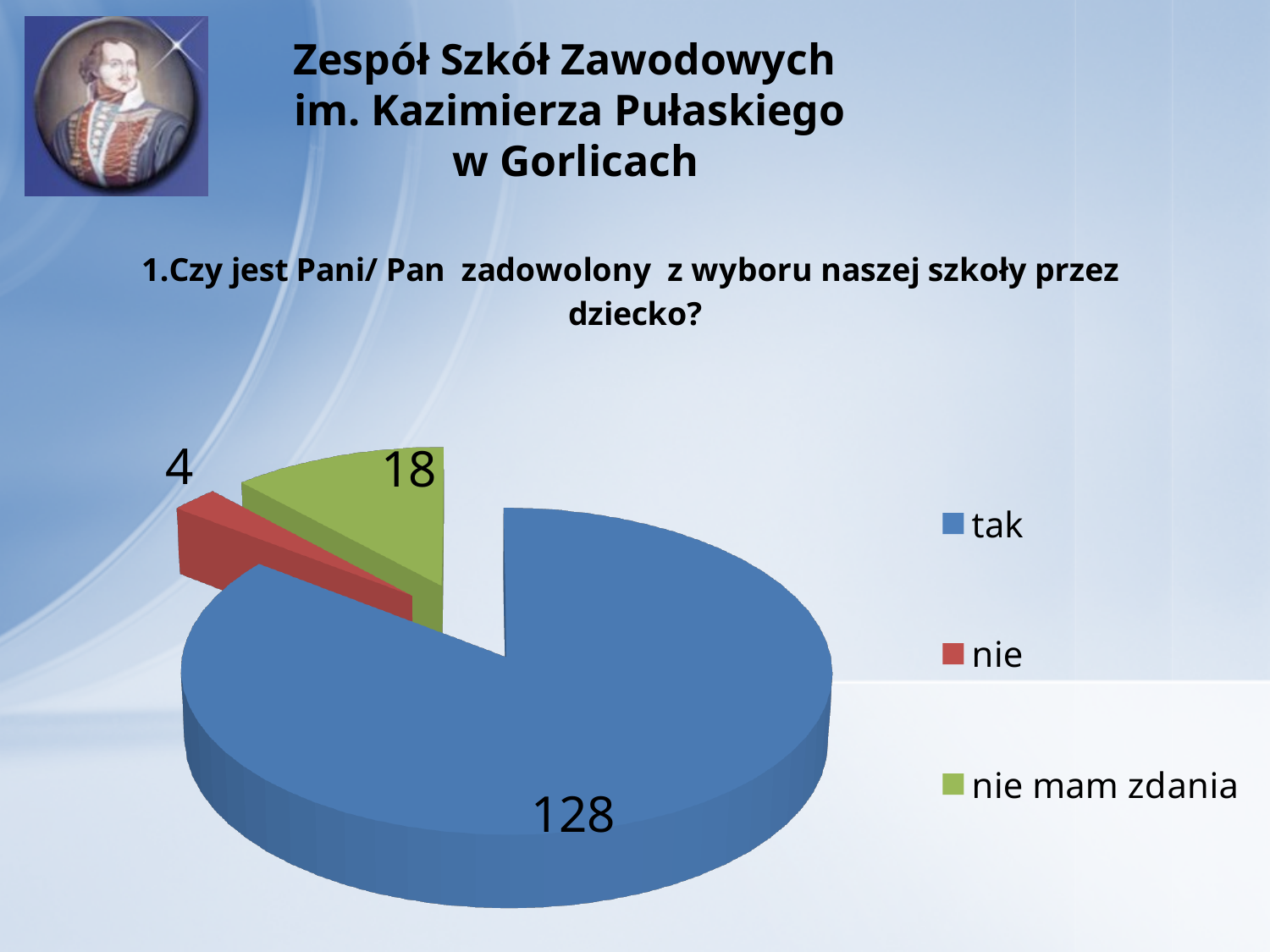
Which has more responses, "nie" or "nie mam zdania"? nie mam zdania What is the difference between the number of "nie mam zdania" responses and the number of "nie" responses? 14 What colour is the slice for "nie mam zdania"? green Which answer category has the smallest slice of the pie? nie What kind of chart is shown on the slide? pie chart What is the total number of responses across all slices of the pie? 150 How many responses are shown for "tak"? 128 Which answer category has the largest slice of the pie? tak How many responses are shown for "nie"? 4 What is the difference between the number of "tak" responses and the number of "nie mam zdania" responses? 110 How many categories does the pie chart have? 3 How many responses are shown for "nie mam zdania"? 18